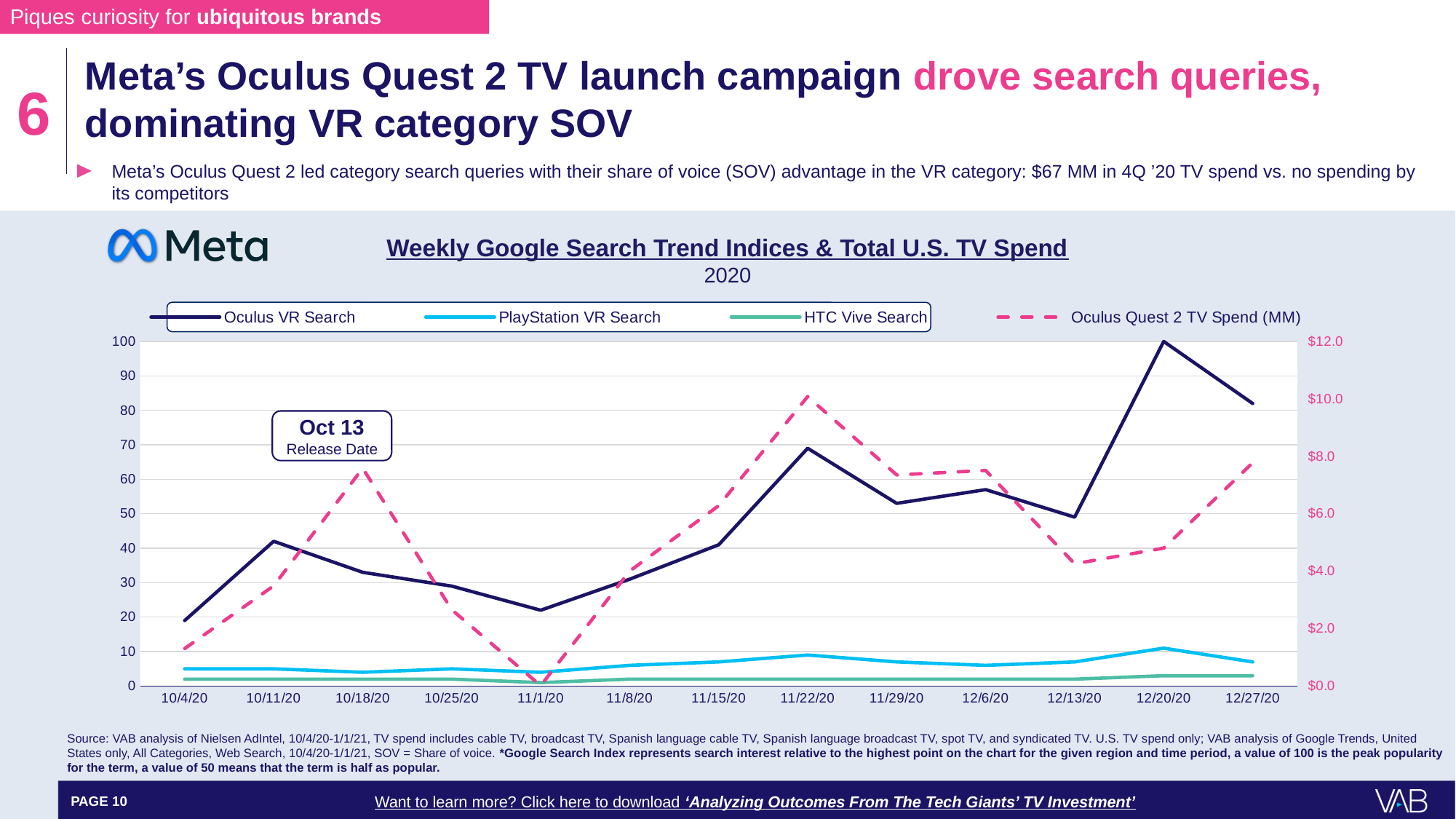
On which date is Oculus Quest 2 TV Spend (MM) at its highest? 11/22/20 What release date is annotated in the box on the chart? Oct 13 How many series does the chart legend list? 4 On which date is Oculus Quest 2 TV Spend (MM) at its lowest? 11/1/20 On which date does Oculus VR Search reach its highest value? 12/20/20 Is the Oculus VR Search value on 11/22/20 greater or less than 60? greater On 12/20/20, which is larger: Oculus VR Search or PlayStation VR Search? Oculus VR Search Is the Oculus VR Search value on 11/1/20 greater or less than 30? less What kind of chart is shown on the slide? Line chart Is the Oculus Quest 2 TV Spend (MM) on 11/1/20 greater or less than $2.0? less How many weekly dates are shown on the x axis of the chart? 13 What is the Oculus VR Search index value on 12/20/20? 100